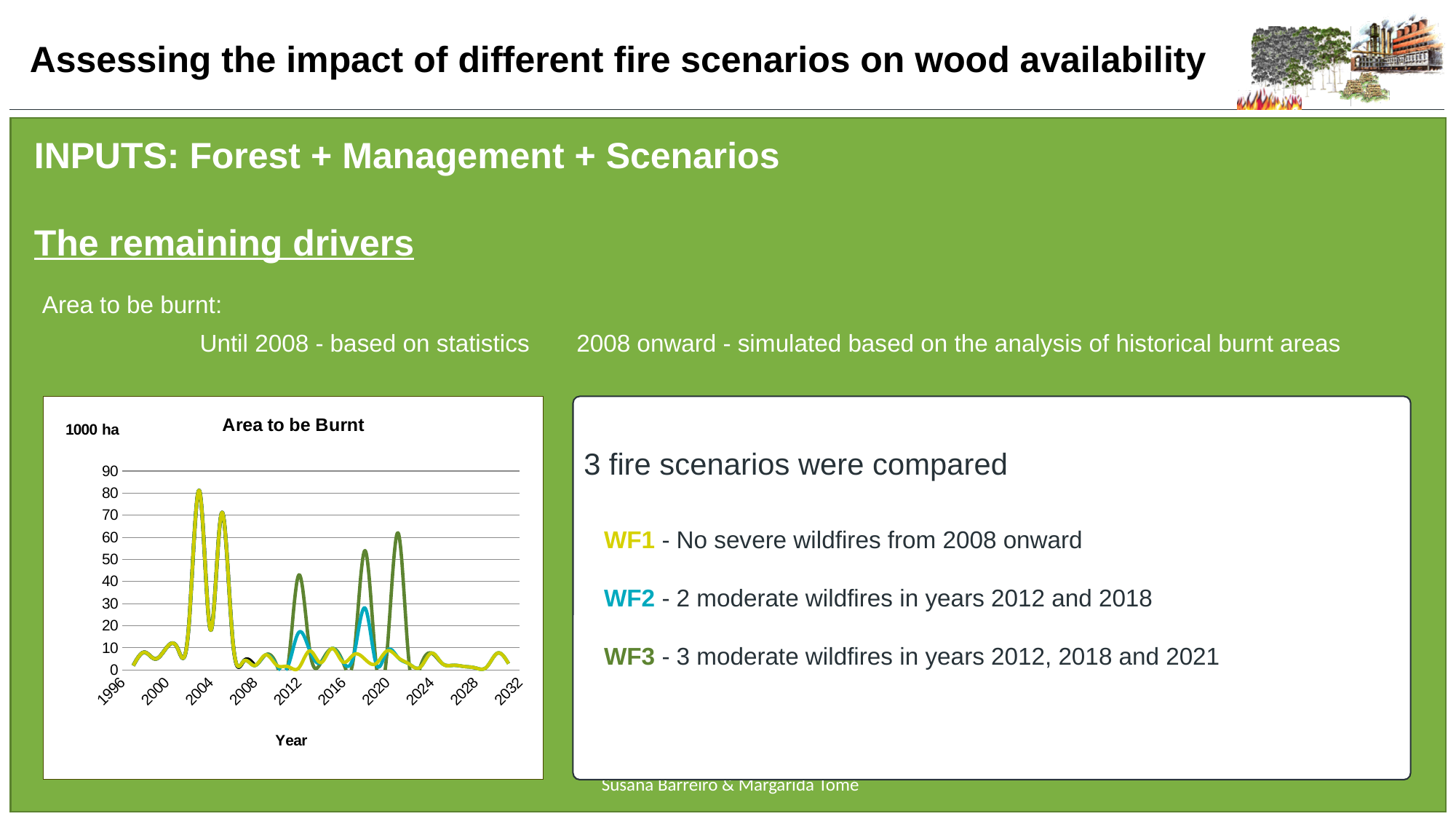
Is the peak of the green (WF3) line around 2012 greater or less than 40? greater What unit is shown on the y axis of the chart? 1000 ha Is the peak of the cyan (WF2) line around 2018 greater or less than 30? less Is the peak of the green (WF3) line around 2018 greater or less than 50? greater Which scenario line reaches the highest values after 2008: WF1, WF2 or WF3? WF3 What is the title of the chart on the slide? Area to be Burnt Does the highest peak of the chart occur before or after 2008? before What type of chart is shown on the slide? line chart How many year labels are shown on the x axis of the chart? 10 What is the highest value labelled on the y axis of the chart? 90